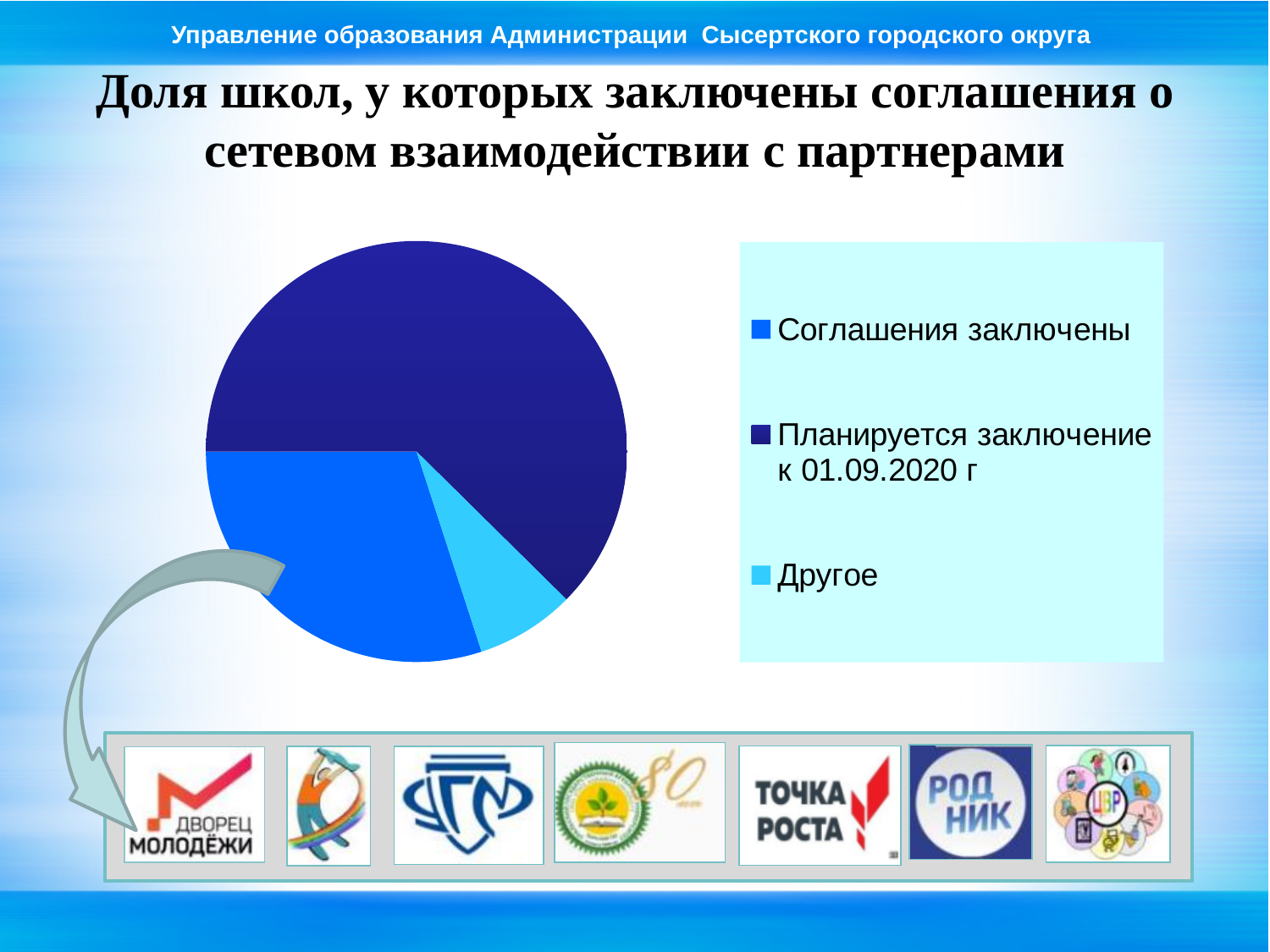
Which legend entry is shown in the darkest blue colour? Планируется заключение к 01.09.2020 г Which category has the smallest slice in the pie chart? Другое Does the largest slice of the pie chart take up more or less than half of the pie? More What is the title of the chart on the slide? Доля школ, у которых заключены соглашения о сетевом взаимодействии с партнерами What kind of chart is shown on the slide? Pie chart Which category has the largest slice in the pie chart? Планируется заключение к 01.09.2020 г How many slices does the pie chart have? 3 How many entries does the legend of the pie chart list? 3 Which slice is larger: "Соглашения заключены" or "Другое"? Соглашения заключены Which slice is larger: "Планируется заключение к 01.09.2020 г" or "Соглашения заключены"? Планируется заключение к 01.09.2020 г